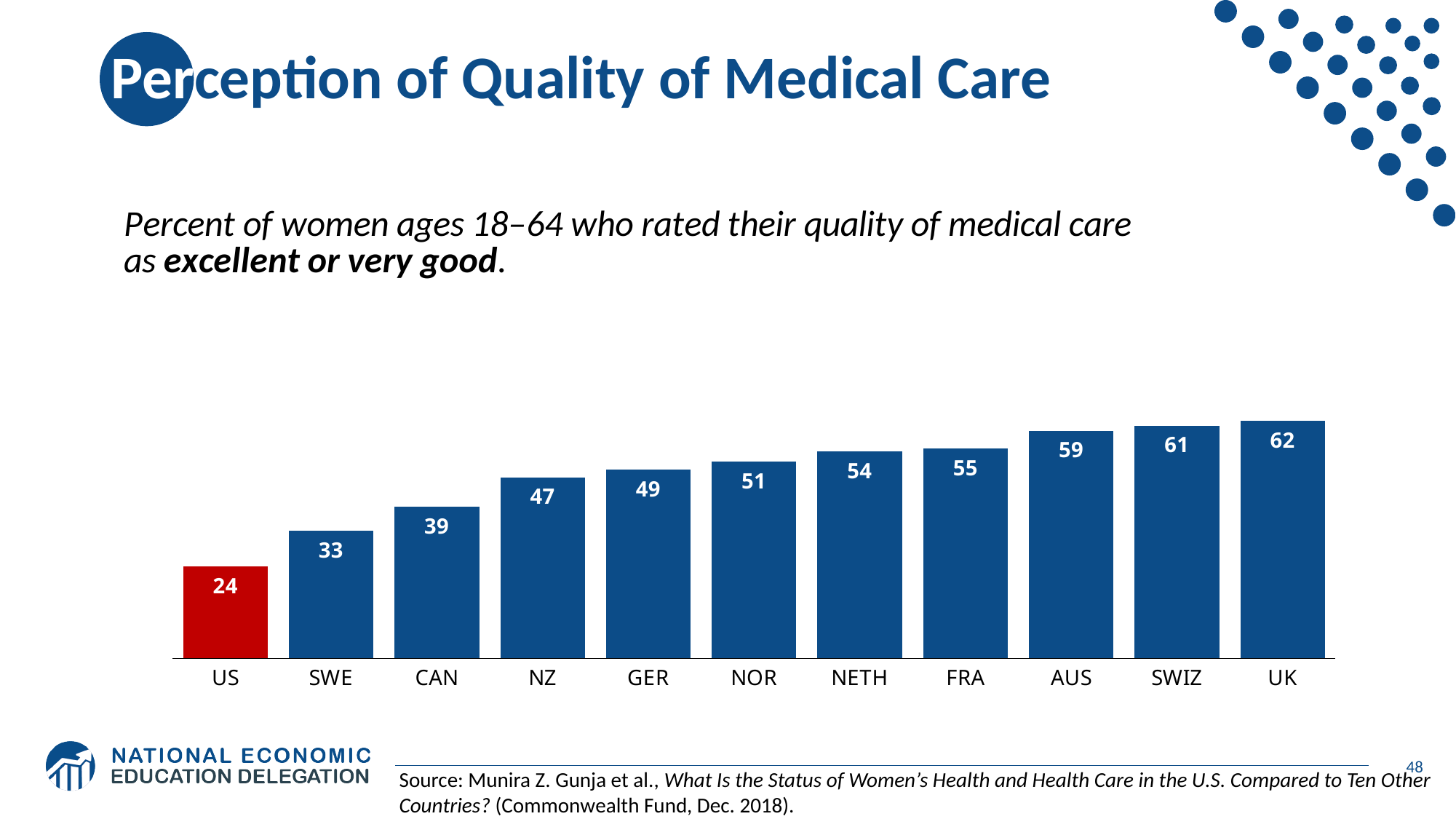
What kind of chart is shown on the slide? Bar chart What is the value for GER? 49 Do the values rise or fall from left to right along the x axis? Rise What is the difference between the values for NETH and CAN? 15 How many countries are shown in the chart? 11 Which bar is coloured red rather than blue? US Which country has the highest value? UK What is the value for AUS? 59 Which country has the lowest value? US Which has a larger value, SWE or NZ? NZ What is the difference between the values for UK and US? 38 What is the value for the US? 24